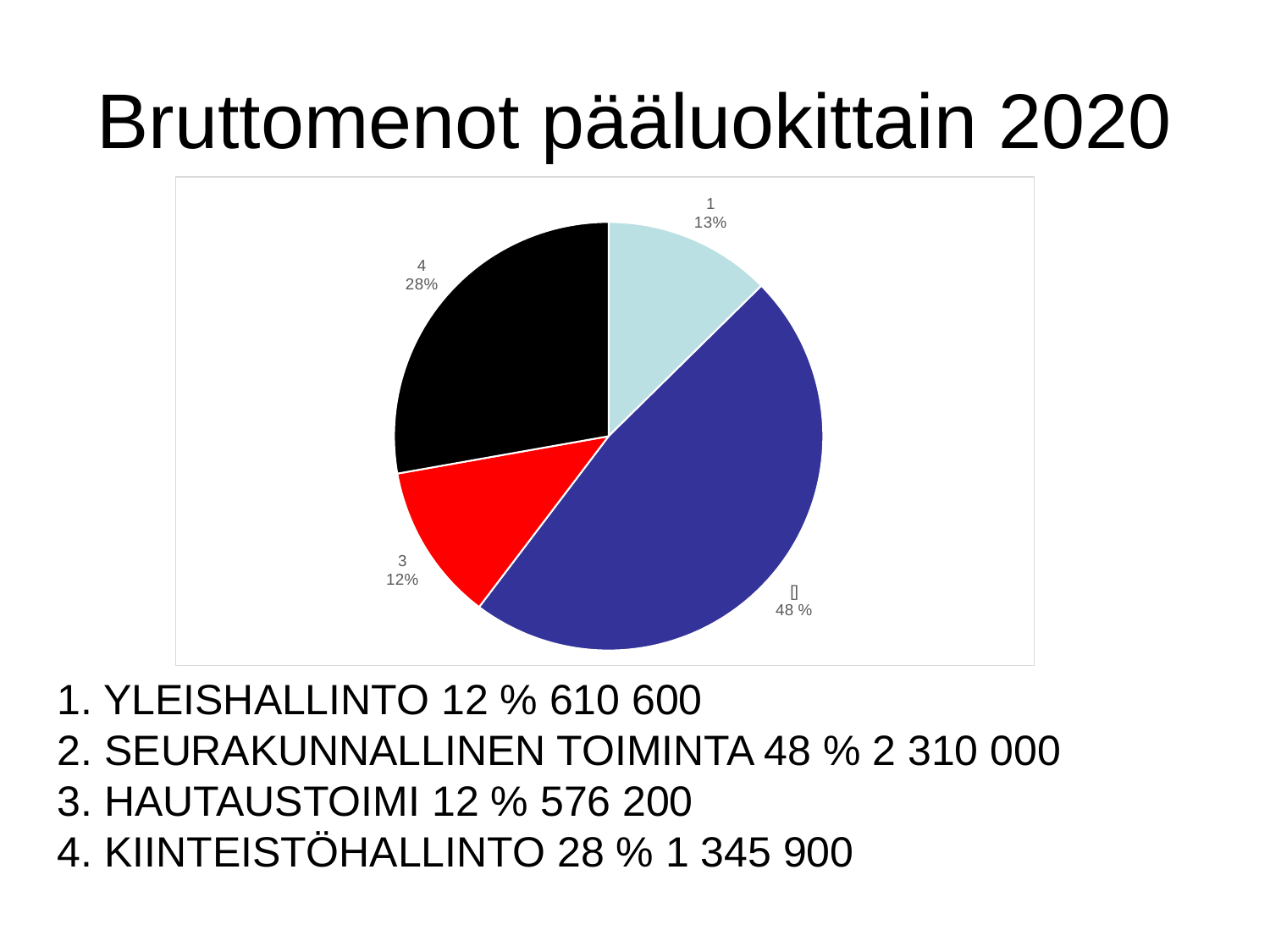
What is the difference in percentage points between the largest slice (48 %) and slice 4 (28%)? 20 Which numbered slice has the smallest percentage label in the pie chart? 3 What is the difference in percentage points between slice 4 and slice 3 in the pie chart? 16 How many slices does the pie chart have? 4 What colour is slice 4 in the pie chart? black What percentage is shown for slice 3 in the pie chart? 12% What is the title of the slide containing the pie chart? Bruttomenot pääluokittain 2020 What percentage label does the largest slice of the pie chart show? 48 % What percentage is shown for slice 1 in the pie chart? 13% Which slice is larger in the pie chart, slice 4 or slice 1? 4 What kind of chart is shown on the slide? pie chart What percentage is shown for slice 4 in the pie chart? 28%